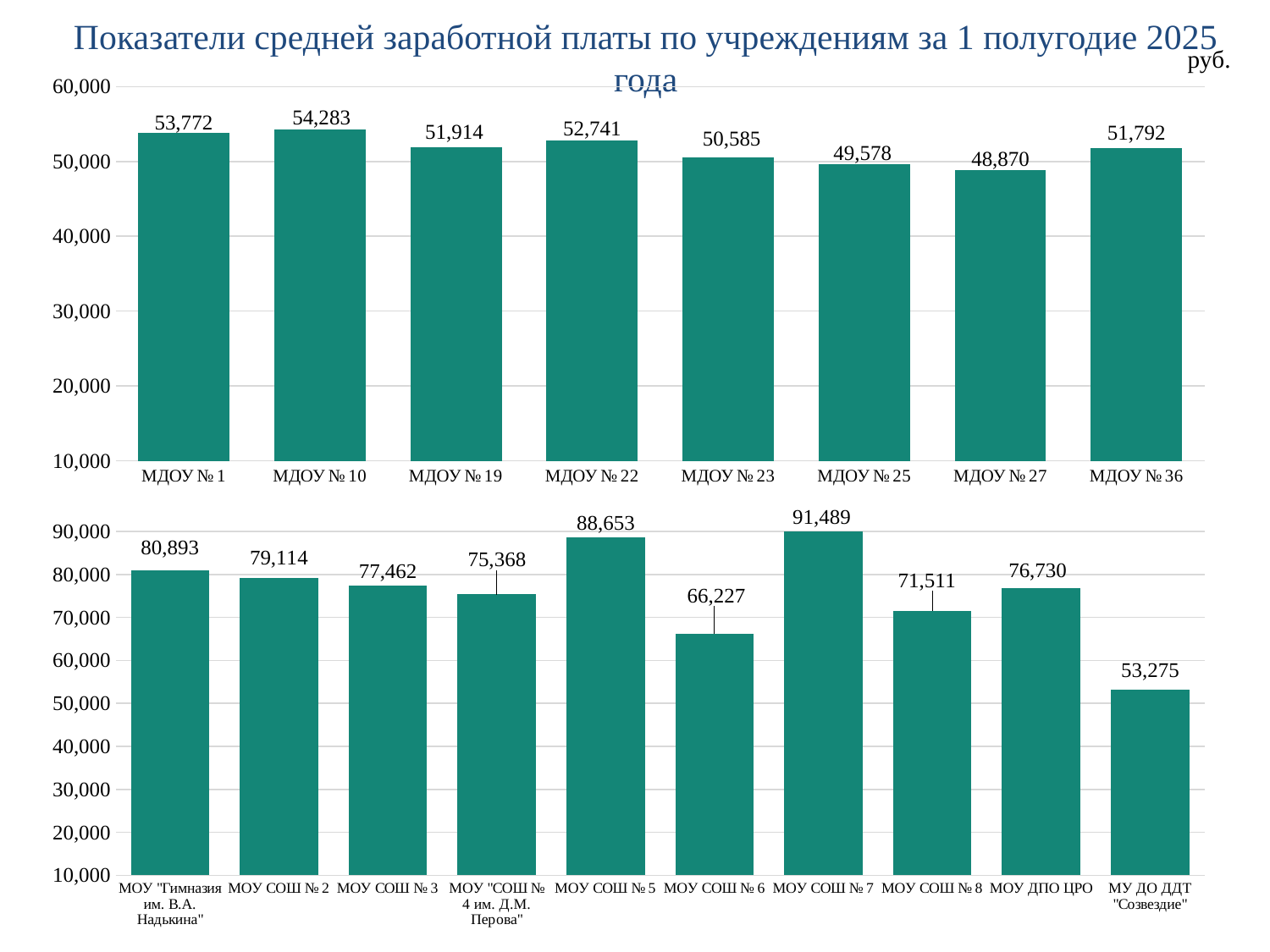
What type of chart is the top chart? Bar chart In the bottom chart, which institution has the highest value? МОУ СОШ № 7 In the top chart, how many institutions are shown? 8 In the top chart, which institution has the highest value? МДОУ № 10 In the top chart, what is the difference between the values for МДОУ № 10 and МДОУ № 27? 5,413 In the bottom chart, what is the value for МОУ СОШ № 6? 66,227 In the top chart, what is the value for МДОУ № 22? 52,741 In the bottom chart, what is the difference between the values for МОУ СОШ № 5 and МОУ СОШ № 6? 22,426 In the bottom chart, which institution has the lowest value? МУ ДО ДДТ "Созвездие" In the bottom chart, how many institutions are shown? 10 In the bottom chart, which is larger: the value for МОУ СОШ № 2 or the value for МОУ ДПО ЦРО? МОУ СОШ № 2 In the top chart, which institution has the lowest value? МДОУ № 27